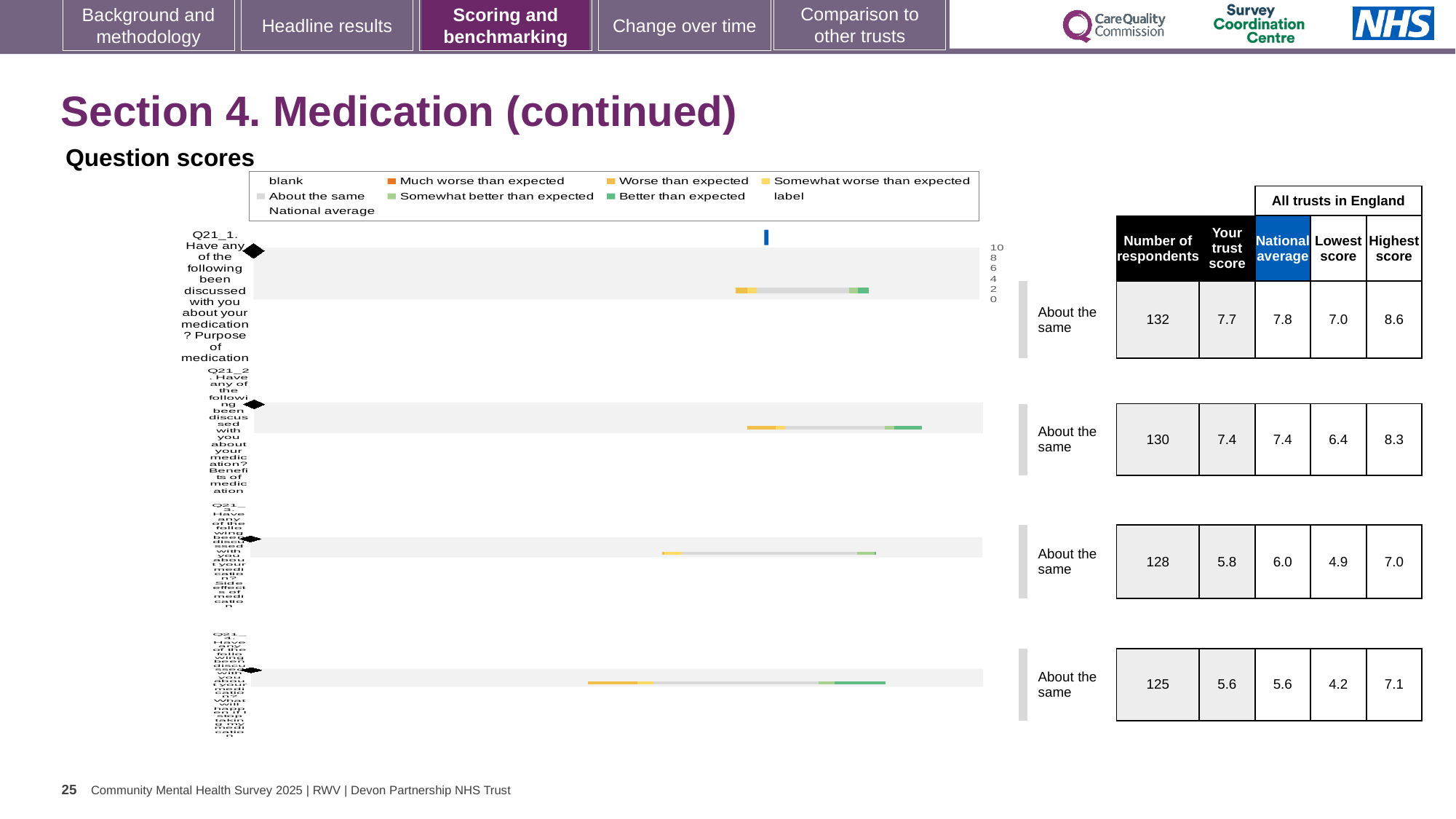
What is the lowest score across all trusts in England for Q21_4, the fourth question row? 4.2 Which question row has the highest 'Your trust score'? Q21_1 Is the trust score for Q21_3 larger or smaller than its national average? smaller What kind of chart is used to show the question scores on this slide? bar chart How many respondents answered Q21_3, the third question row? 128 What is the national average for Q21_2 (Benefits of medication)? 7.4 What is the 'Your trust score' for Q21_1 (Purpose of medication)? 7.7 Which question row has the lowest number of respondents? Q21_4 What benchmark category is shown for all four questions on this slide? About the same What is the highest value shown on the chart's score axis? 10 How many questions (bars) are plotted in the question scores chart? 4 What is the difference between the highest score and the lowest score for Q21_1? 1.6